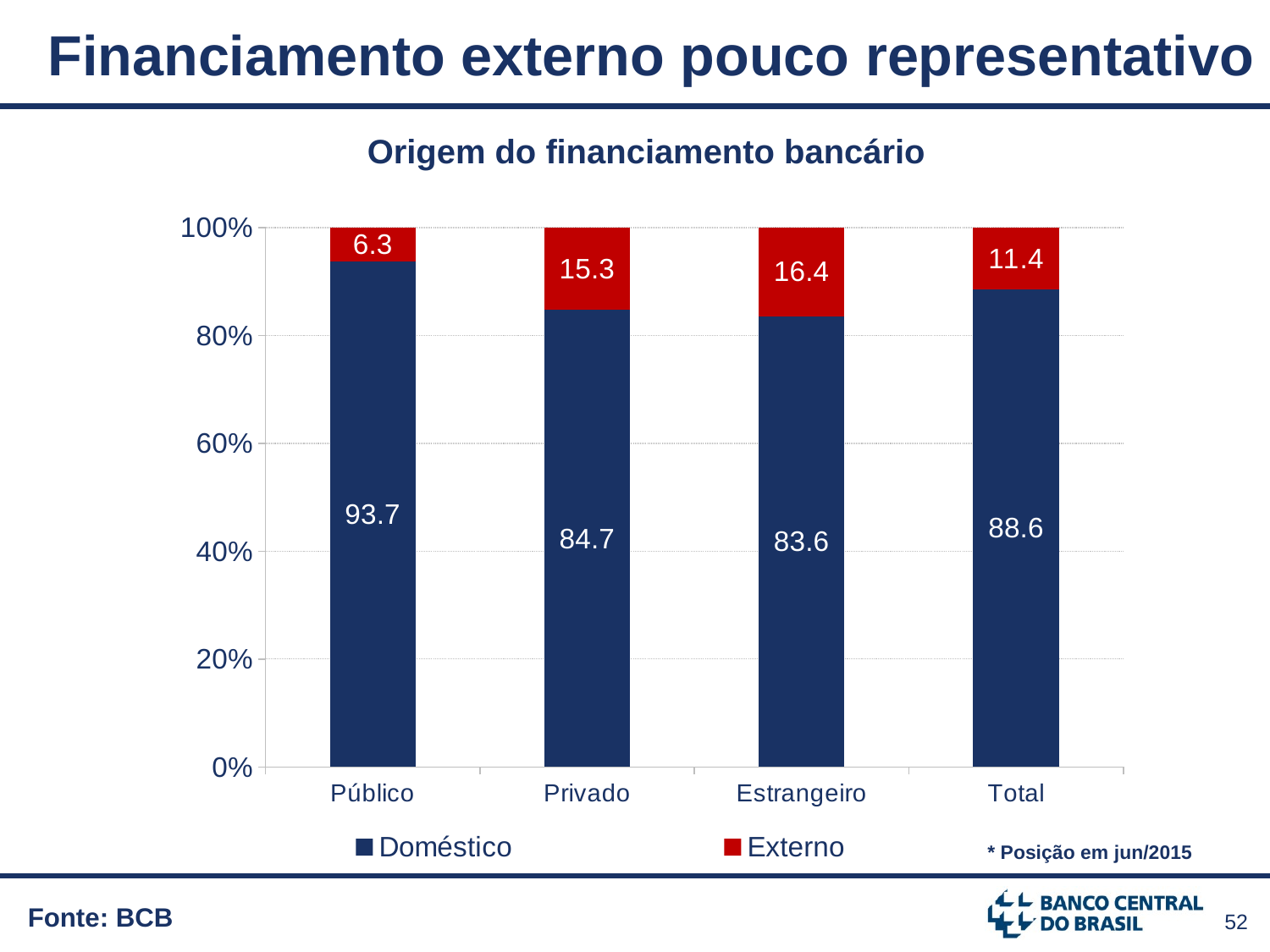
What is the Doméstico value for Privado? 84.7 What is the title of the chart? Origem do financiamento bancário Which category has the lowest Doméstico value? Estrangeiro What kind of chart is shown? Stacked bar chart How many series does the legend list? 2 How many categories are shown on the x axis? 4 What is the Externo value for Total? 11.4 What is the Doméstico value for Público? 93.7 Which is larger, the Doméstico value for Total or for Privado? Total Which category has the highest Externo value? Estrangeiro What is the difference between the Externo values for Privado and Público? 9.0 What is the Externo value for Estrangeiro? 16.4